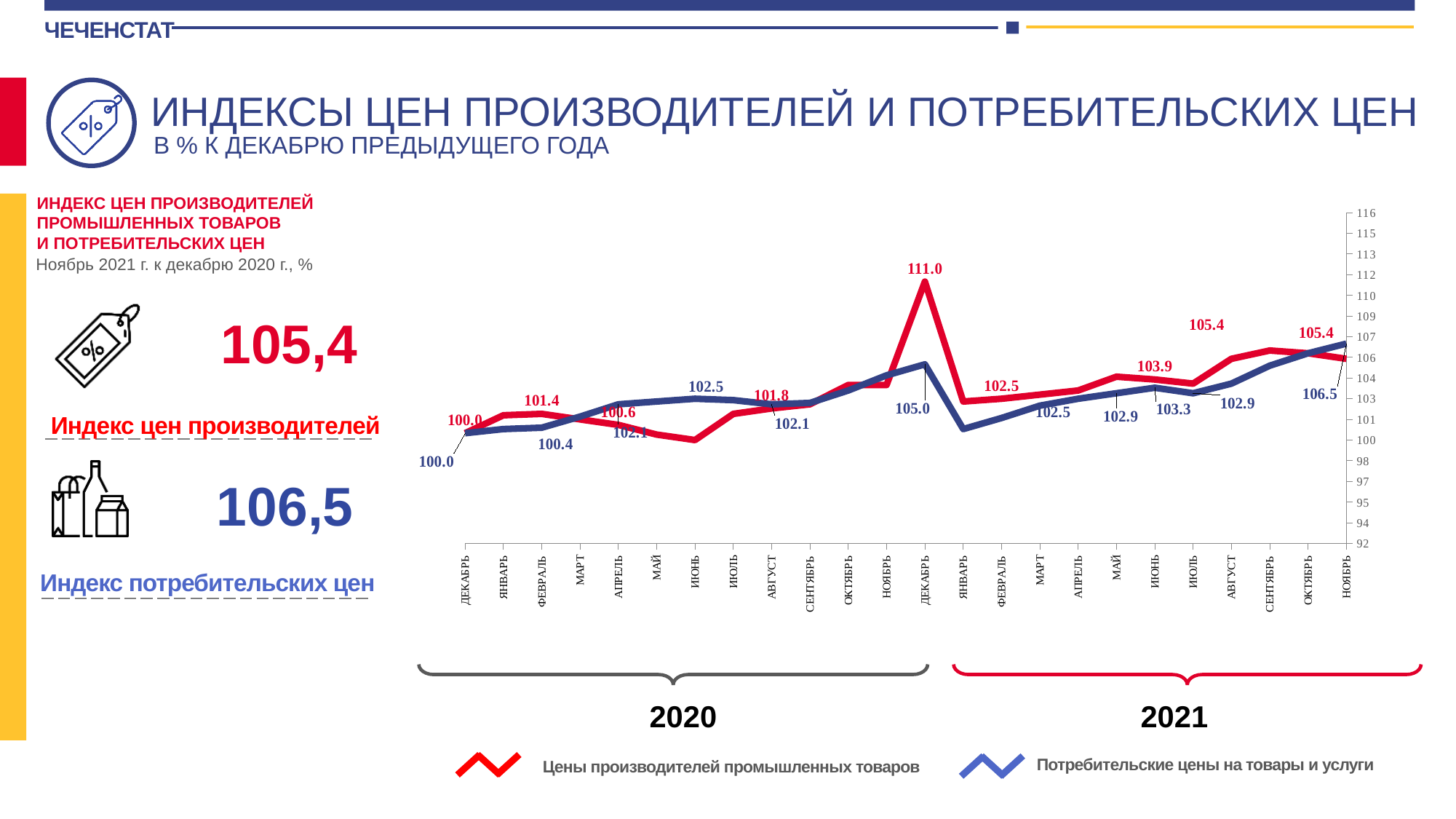
What is the value of the producer price index in November 2021? 105.4 What is the value of the producer price index (Цены производителей промышленных товаров) in December 2020? 111.0 Is the consumer price index in January 2021 greater or less than 102? less What is the value of the consumer price index in November 2021? 106.5 Which series has the larger value in November 2021, producer prices or consumer prices? consumer prices (106.5) In which month does the producer price index reach its highest value on the chart? December 2020 (111.0) What type of chart is shown on the slide? line chart Does the producer price index rise or fall from December 2020 to January 2021? fall What is the difference between the producer price index and the consumer price index in December 2020? 6.0 How many series does the chart legend list? 2 Which colour represents producer prices of industrial goods in the chart? red What is the value of the consumer price index (Потребительские цены на товары и услуги) in December 2020? 105.0